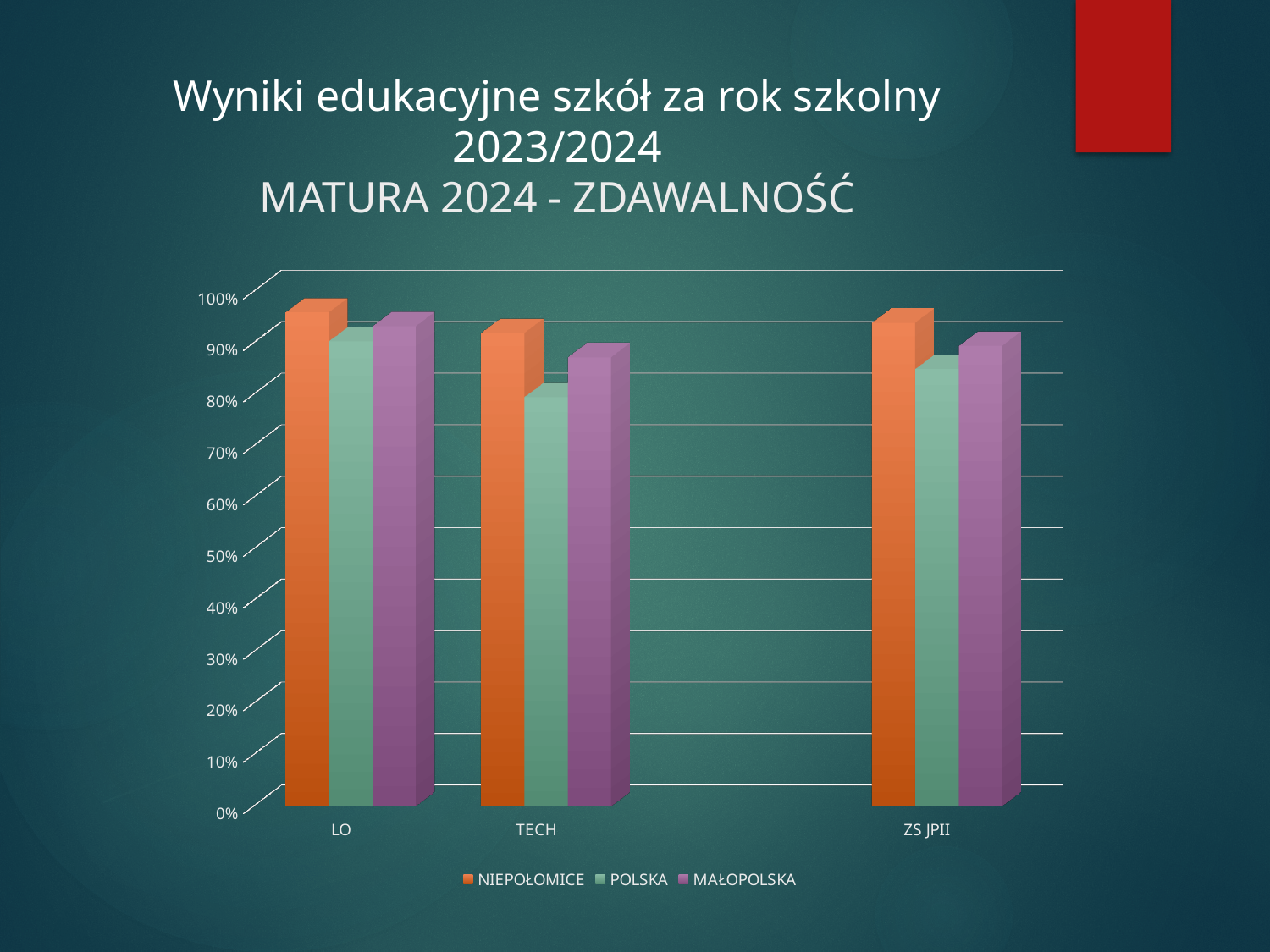
How many categories are shown on the x axis? 3 Is the NIEPOŁOMICE value for LO greater or less than 90%? greater Is the MAŁOPOLSKA value for ZS JPII greater or less than 80%? greater Which series has the lowest value in every category? POLSKA What colour are the NIEPOŁOMICE bars? orange Which category has the lowest POLSKA value? TECH How many series does the legend list? 3 For LO, which is larger: the POLSKA value or the MAŁOPOLSKA value? MAŁOPOLSKA Is the POLSKA value for TECH greater or less than 90%? less For TECH, which is larger: the NIEPOŁOMICE value or the POLSKA value? NIEPOŁOMICE Within the TECH category, which series has the highest value? NIEPOŁOMICE What kind of chart is shown on the slide? bar chart